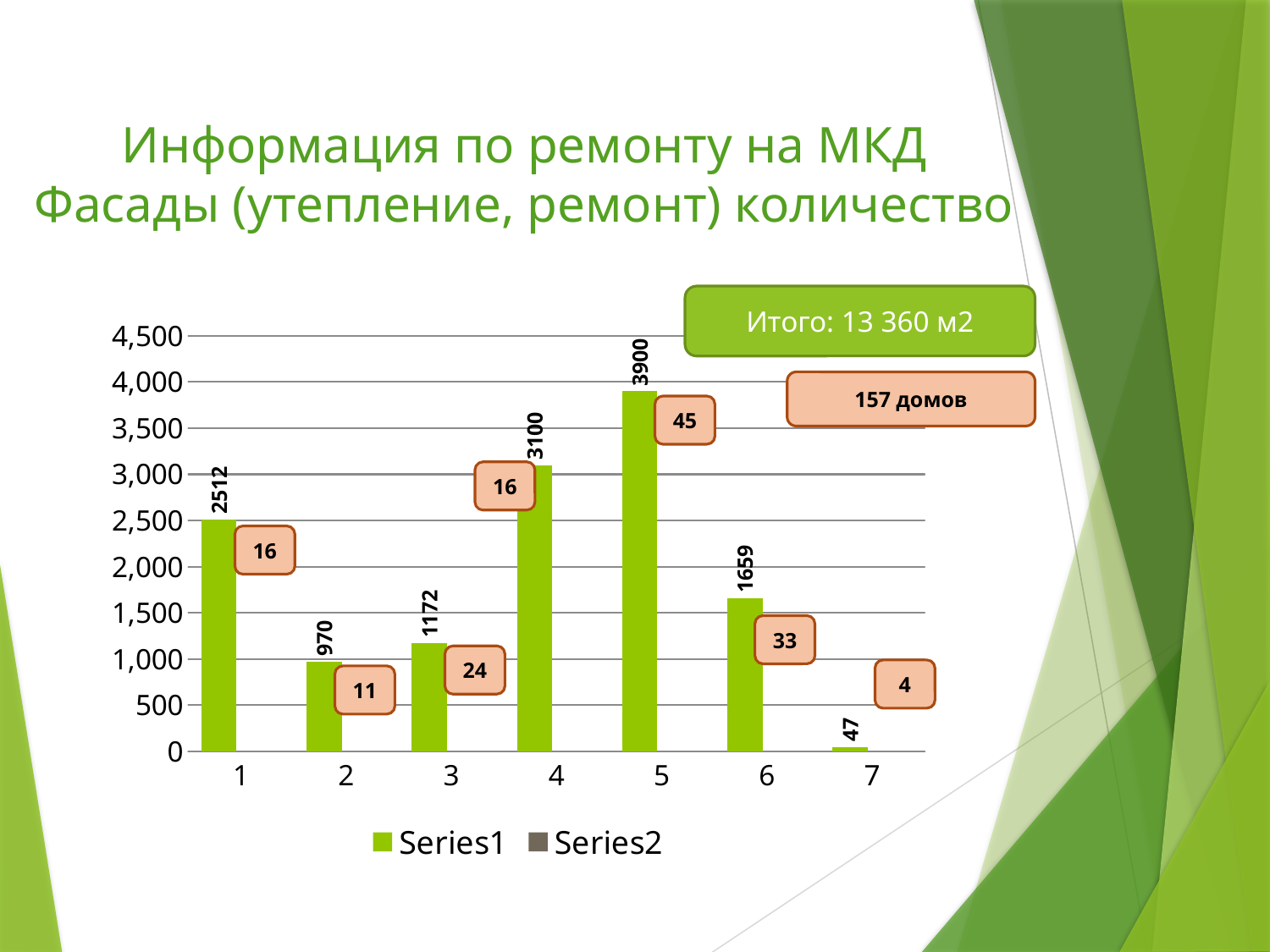
What is the Series1 value for category 7? 47 What is the difference between the Series1 values for category 4 and category 1? 588 Which category has the lowest Series1 value? 7 What type of chart is shown on the slide? bar chart Is the Series1 value for category 4 greater or less than 3,000? greater Which is larger, the Series1 value for category 3 or for category 6? category 6 What is the Series1 value for category 2? 970 What is the Series1 value for category 5? 3900 How many series does the legend list? 2 Which category has the highest Series1 value? 5 How many categories are shown on the x axis? 7 What total is shown in the green callout box above the chart? Итого: 13 360 м2